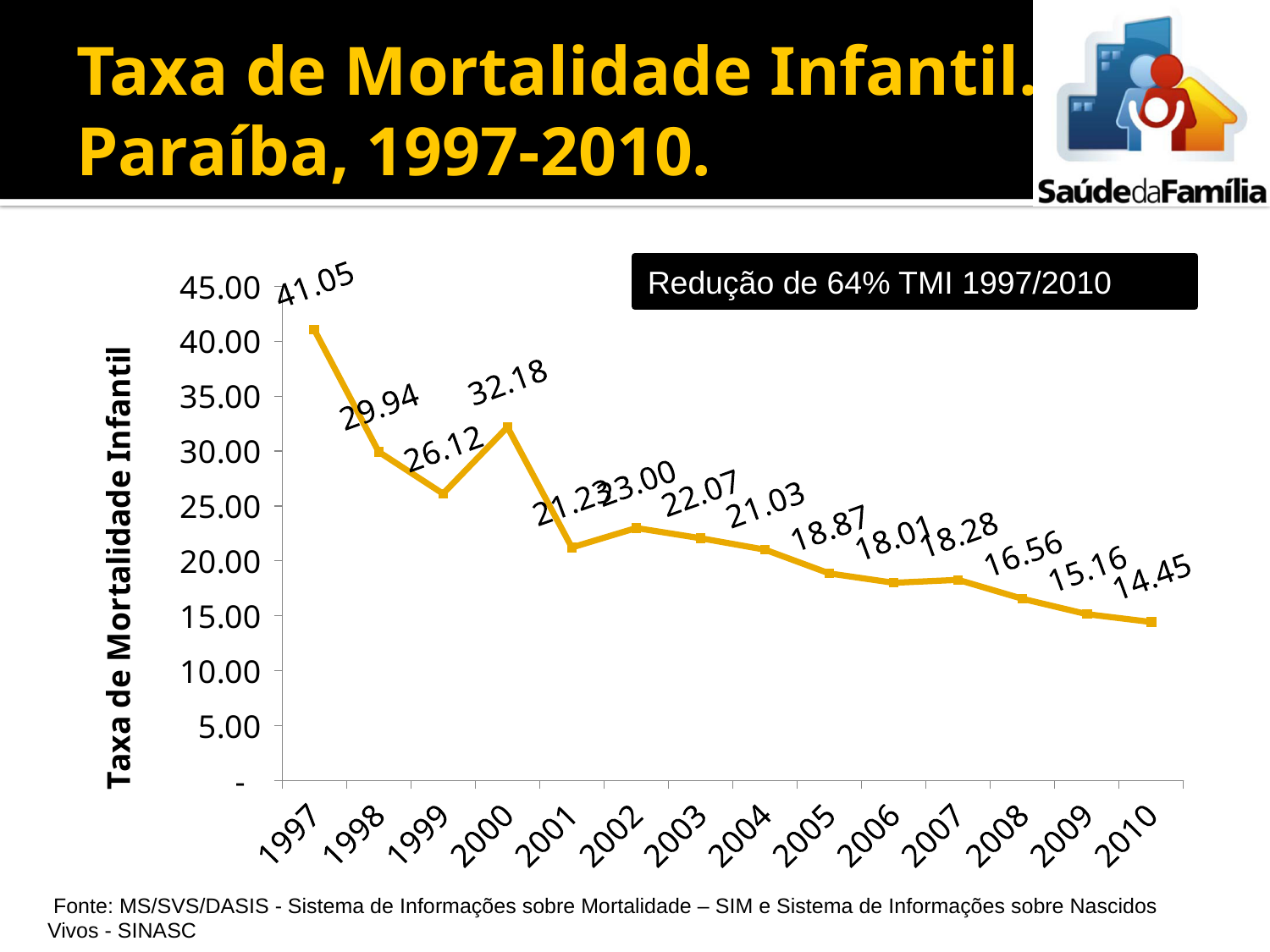
How many years are plotted on the x axis? 14 What is the infant mortality rate value shown for 1997? 41.05 Which year has the larger value, 1999 or 2000? 2000 Which year has the highest infant mortality rate? 1997 Which year has the lowest infant mortality rate? 2010 What is the value shown for 2008? 16.56 What is the value shown for 2010? 14.45 What is the difference between the values for 1997 and 2010? 26.60 What kind of chart is shown on the slide? line chart Is the value for 2003 greater or less than 20.00? greater Overall, do the values rise or fall from 1997 to 2010? fall What is the value shown for 2000? 32.18